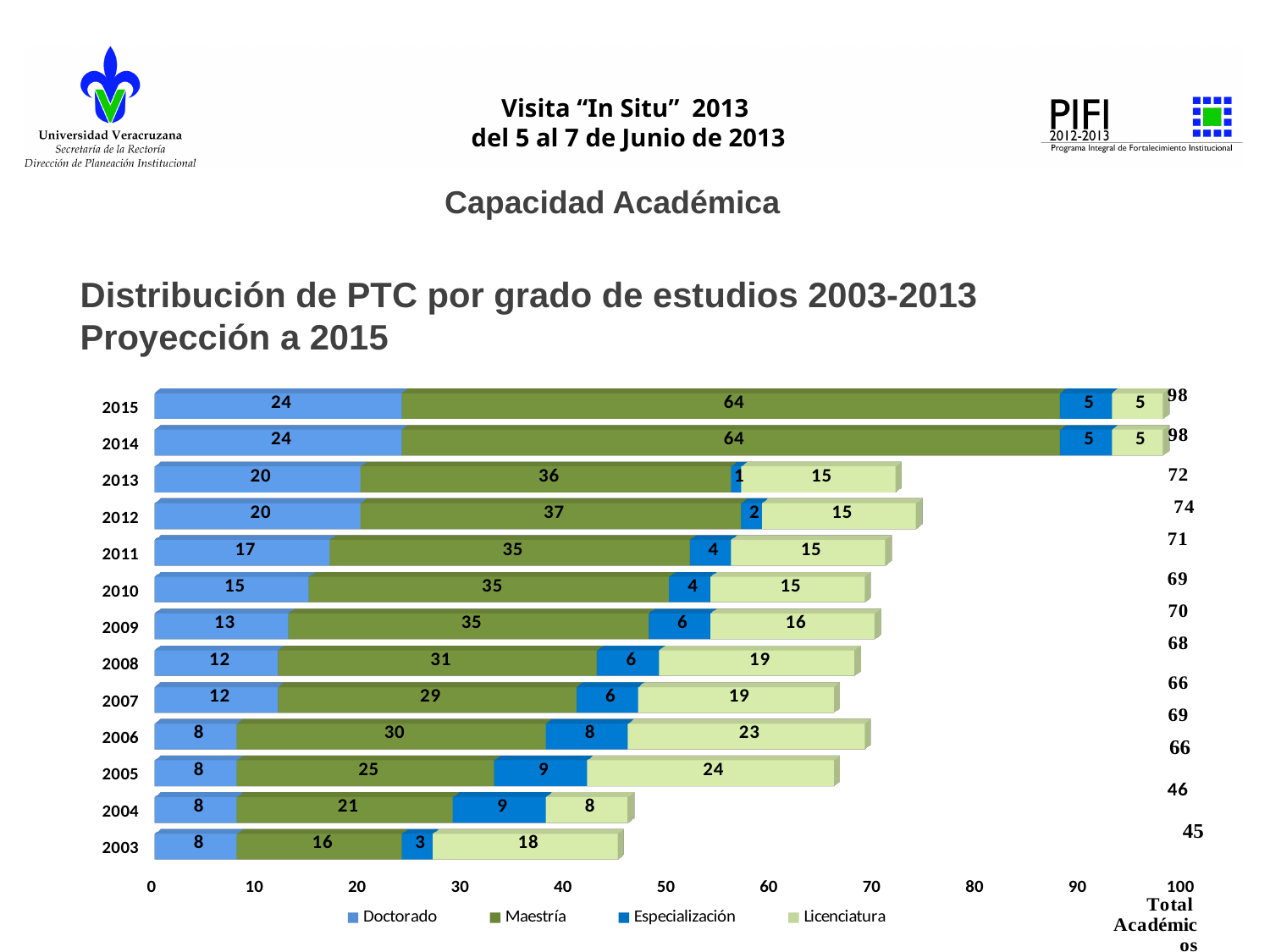
Which is larger, the Licenciatura value for 2006 or for 2008? 2006 What is the total of the stacked bar for 2011? 71 What is the difference between the Maestría values for 2015 and 2013? 28 How many years are shown on the chart? 13 What is the Especialización value for 2012? 2 What type of chart is shown on the slide? stacked bar chart Which year has the lowest Maestría value? 2003 What is the Licenciatura value for 2005? 24 What is the total of the stacked bar for 2003? 45 What is the Maestría value for 2013? 36 How many series does the legend list? 4 Which year has the highest Doctorado value? 2014 and 2015